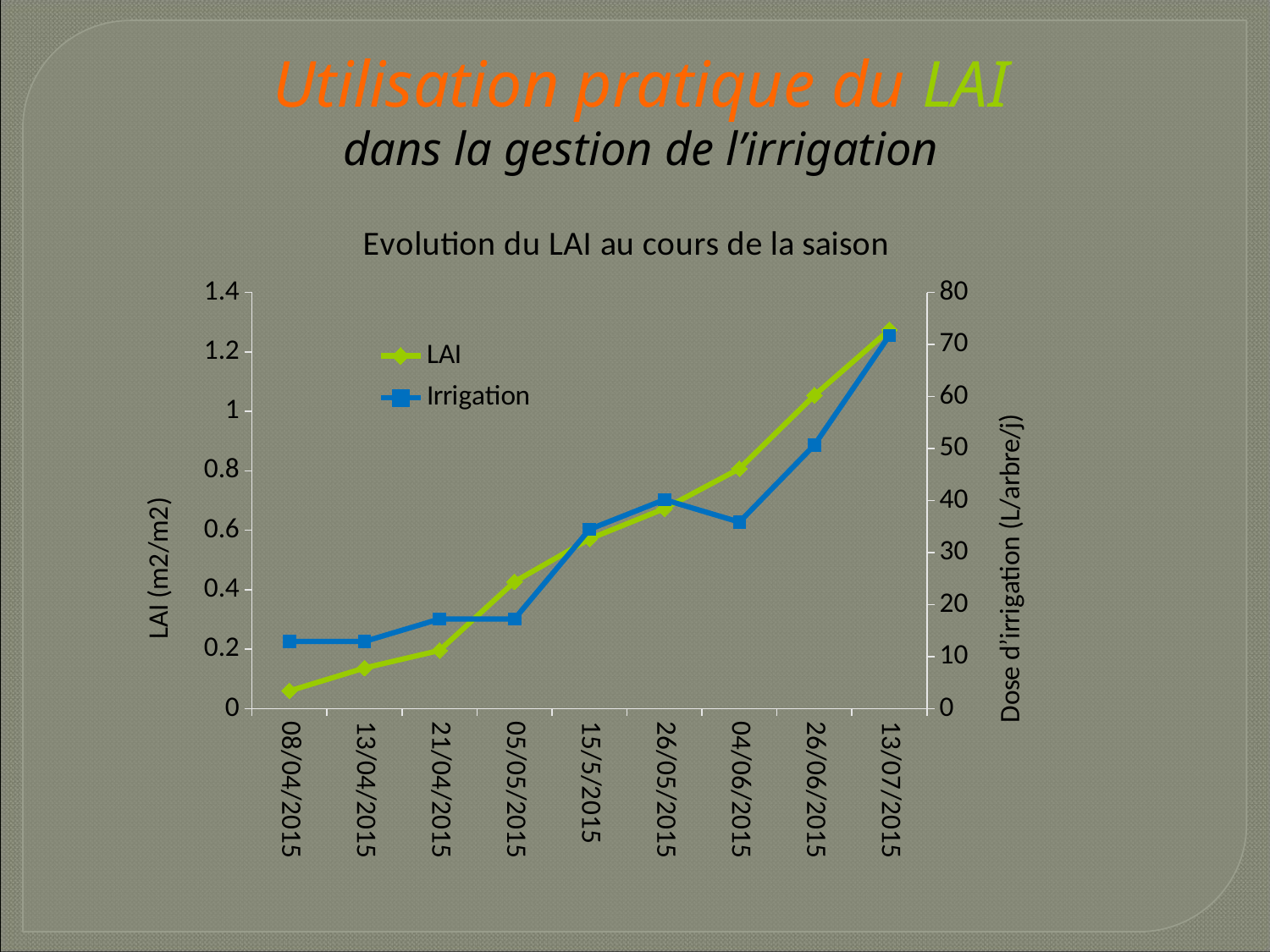
Is the LAI value for 08/04/2015 greater or less than 0.2? less Is the LAI value for 13/07/2015 greater or less than 1.2? greater Is the Irrigation value for 04/06/2015 greater or less than 40? less What is the label of the right-hand vertical axis? Dose d'irrigation (L/arbre/j) Do the LAI values rise or fall along the x axis from 08/04/2015 to 13/07/2015? rise On which date is the LAI value highest? 13/07/2015 On which date is the Irrigation value highest? 13/07/2015 What is the title of the chart? Evolution du LAI au cours de la saison How many series does the legend list? 2 How many dates are plotted along the x axis? 9 On which date is the LAI value lowest? 08/04/2015 What kind of chart is shown on the slide? line chart